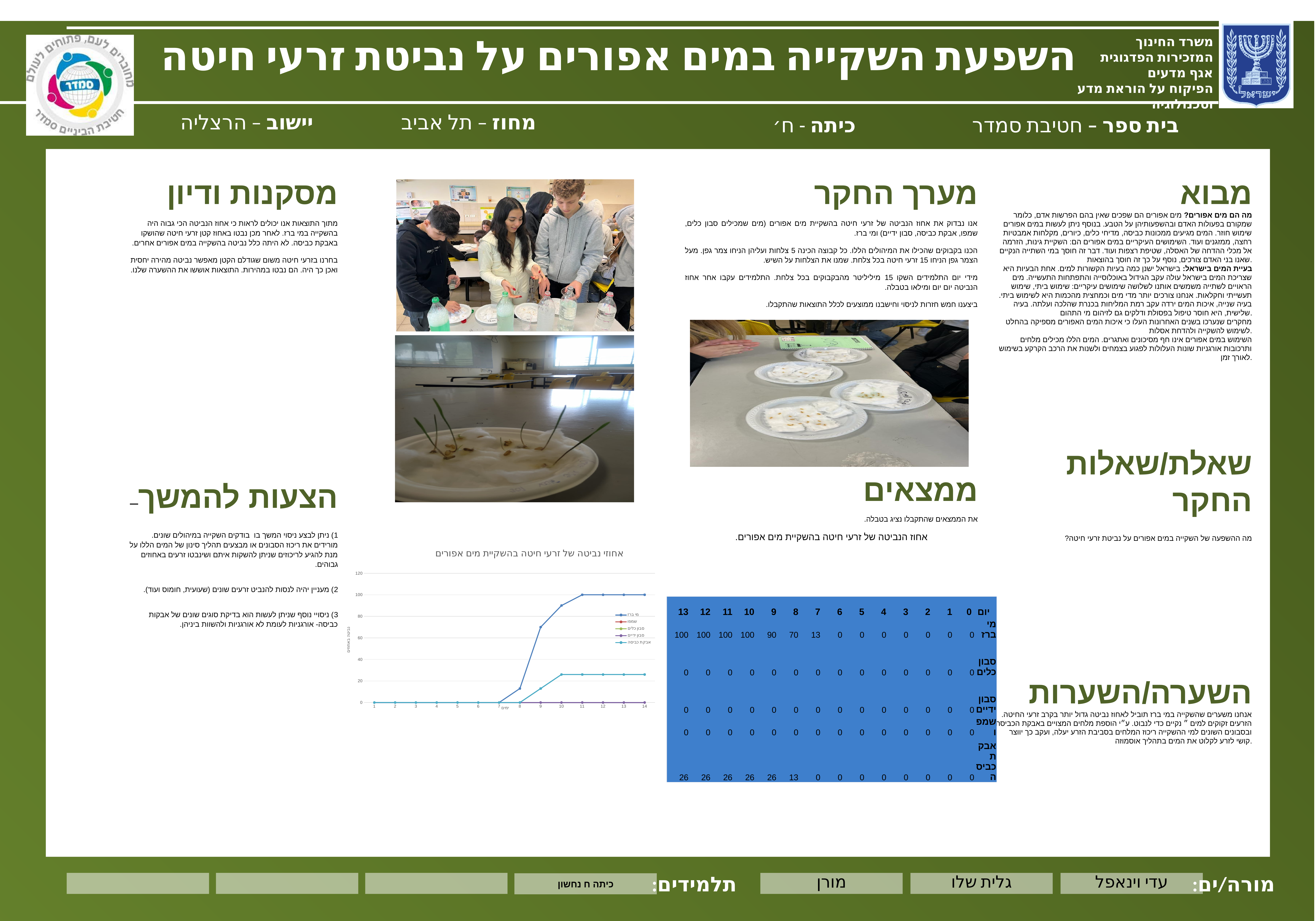
How many series does the chart legend list? 5 What is the title of the chart? אחוזי נביטה של זרעי חיטה בהשקיית מים אפורים Is the value for מי ברז at x = 9 greater or less than 60? greater Is the value for אבקת כביסה at x = 14 greater or less than 40? less At x = 14, which is larger: מי ברז or אבקת כביסה? מי ברז What is the value for מי ברז at x = 1 on the chart? 0 Is the value for מי ברז at x = 8 greater or less than 20? less What kind of chart is shown on the slide? line chart How many points are plotted along the x axis for each series? 14 Which series has the highest value at x = 14? מי ברז What is the value for מי ברז at x = 14 on the chart? 100 Do the values for מי ברז rise or fall along the x axis? rise